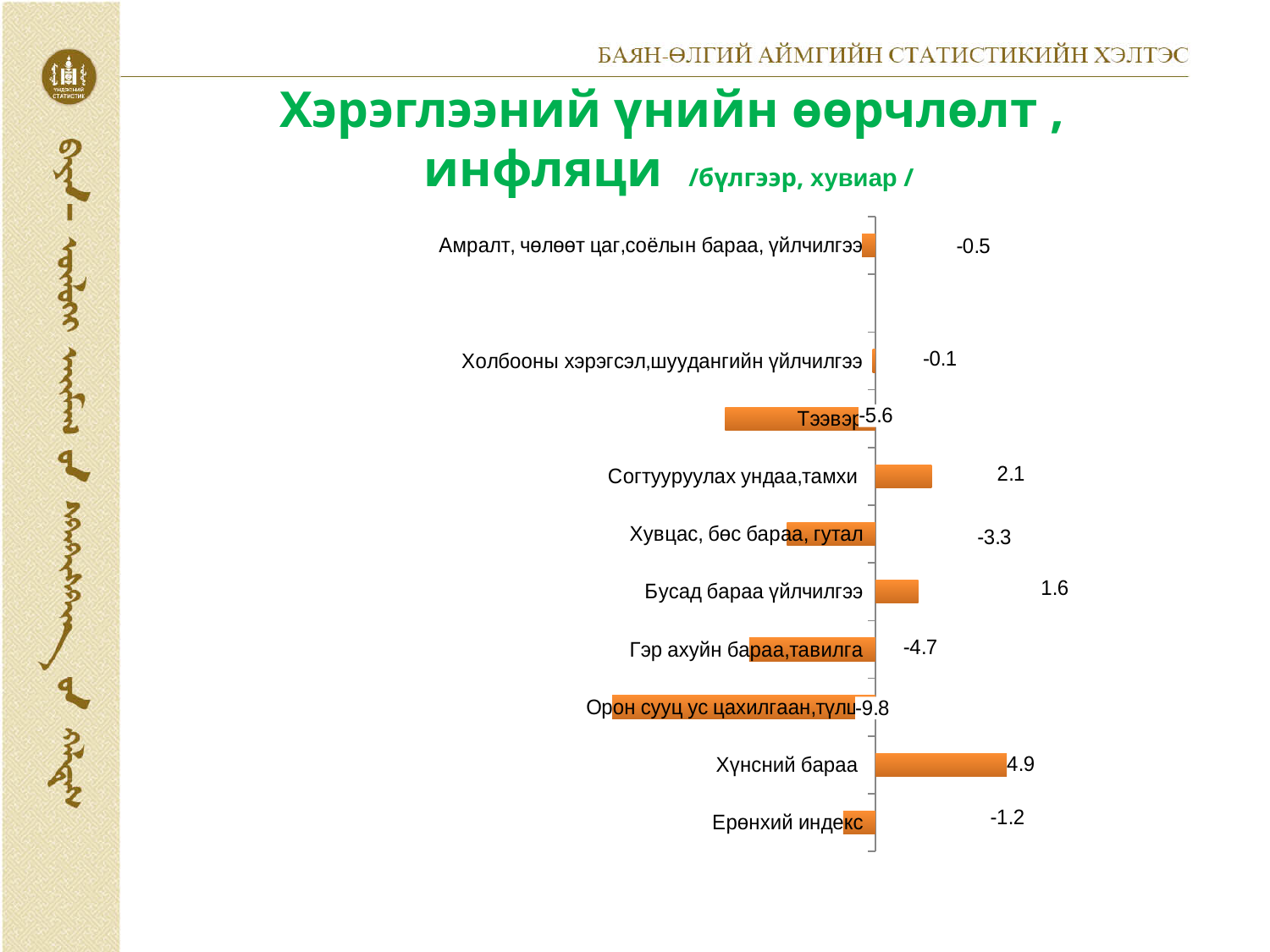
Which category has the lowest value? Орон сууц ус цахилгаан,түлш What type of chart is shown on the slide? bar chart What is the value for Ерөнхий индекс? -1.2 Which is larger, the value for Бусад бараа үйлчилгээ or the value for Согтууруулах ундаа,тамхи? Согтууруулах ундаа,тамхи How many categories are shown in the chart? 10 What is the value for Хүнсний бараа? 4.9 What colour are the bars in the chart? orange What is the value for Гэр ахуйн бараа,тавилга? -4.7 What is the value for Согтууруулах ундаа,тамхи? 2.1 What is the value for Тээвэр? -5.6 What is the difference between the values for Хүнсний бараа and Согтууруулах ундаа,тамхи? 2.8 Which category has the highest value? Хүнсний бараа